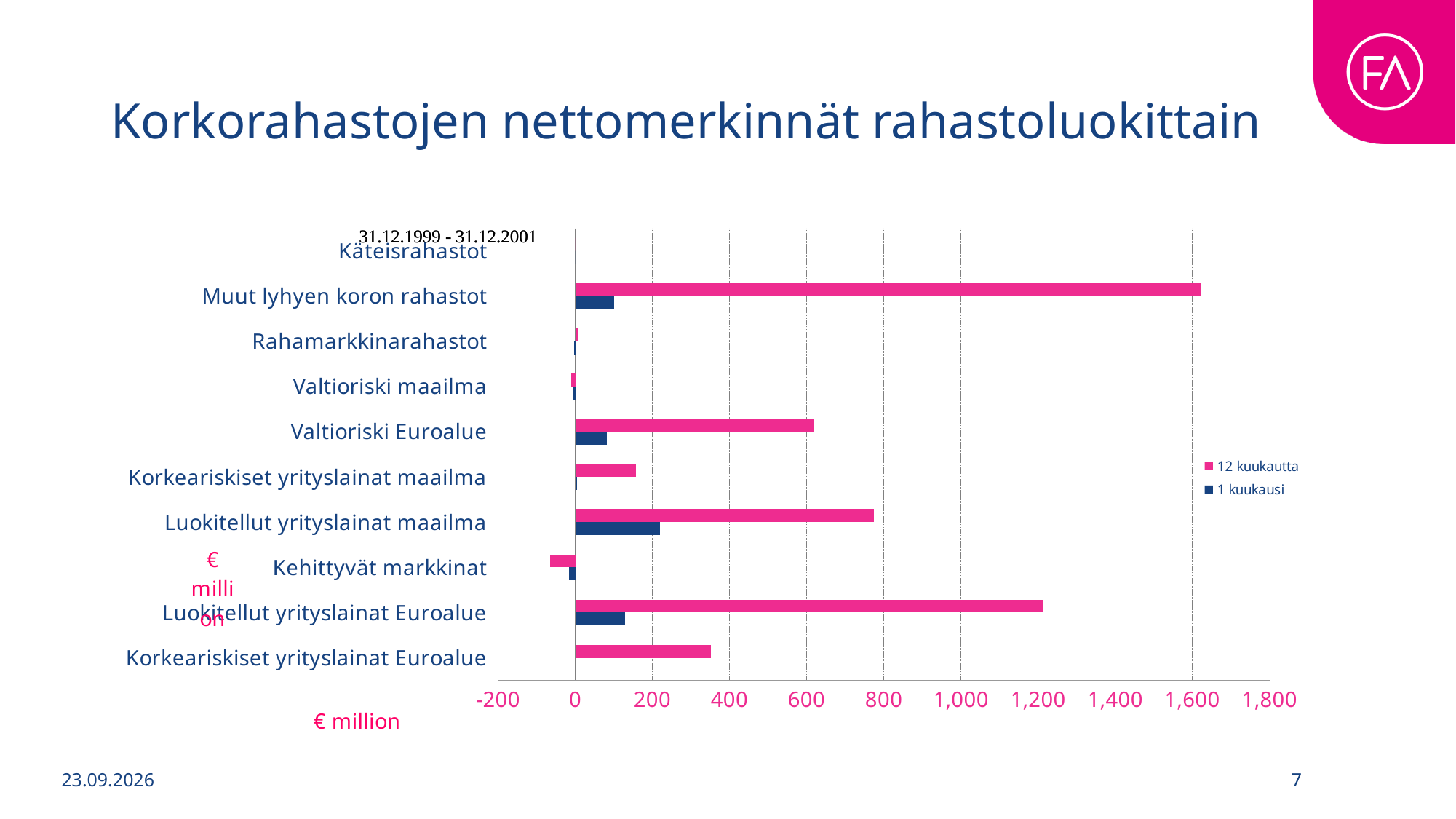
Is the 12 kuukautta value for Korkeariskiset yrityslainat Euroalue greater or less than 400? less Which is larger for the 12 kuukautta series: Luokitellut yrityslainat maailma or Valtioriski Euroalue? Luokitellut yrityslainat maailma What kind of chart is shown on the slide? Bar chart What unit is shown on the horizontal axis of the chart? € million Which category has the highest value for the 12 kuukautta series? Muut lyhyen koron rahastot Which category has the highest value for the 1 kuukausi series? Luokitellut yrityslainat maailma How many series does the legend list? 2 How many fund categories are shown on the vertical axis? 10 Is the 12 kuukautta value for Valtioriski Euroalue greater or less than 600? greater Is the 12 kuukautta value for Muut lyhyen koron rahastot greater or less than 1,600? greater Which category has the lowest value for the 12 kuukautta series? Kehittyvät markkinat